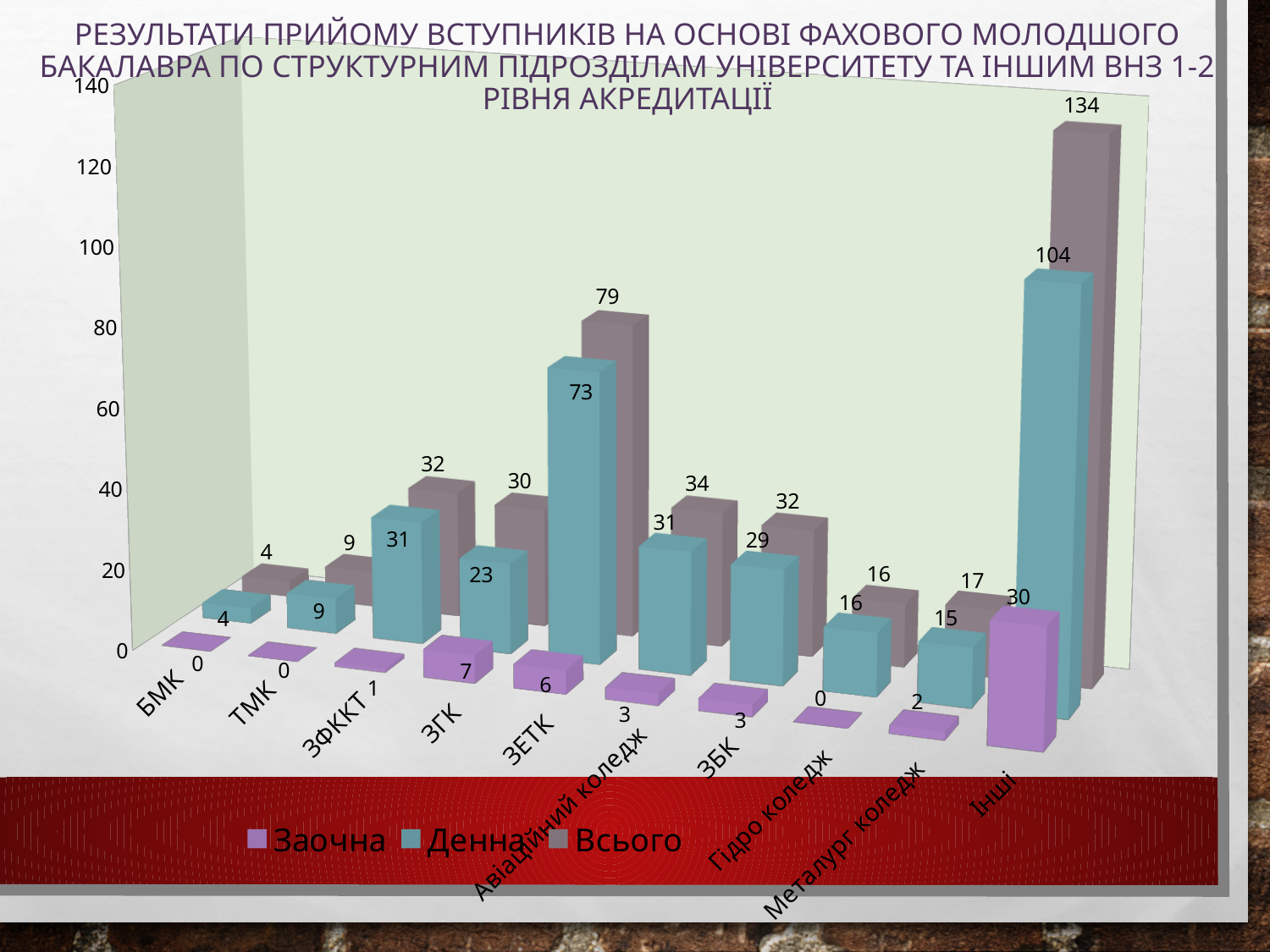
What is the difference between the Всього values for Інші and ЗЕТК? 55 Is the Денна value for Інші greater or less than 100? greater How many series does the legend list? 3 Which category has the highest Всього value? Інші How many categories are shown on the x axis? 10 What type of chart is shown on the slide? bar chart Which series is shown in purple in the legend? Заочна Which is larger, the Денна value for ЗФККТ or the Денна value for ЗБК? ЗФККТ Which category has the lowest Всього value? БМК What is the value of Денна for ЗЕТК? 73 What is the value of Заочна for ЗГК? 7 What is the value of Всього for Інші? 134